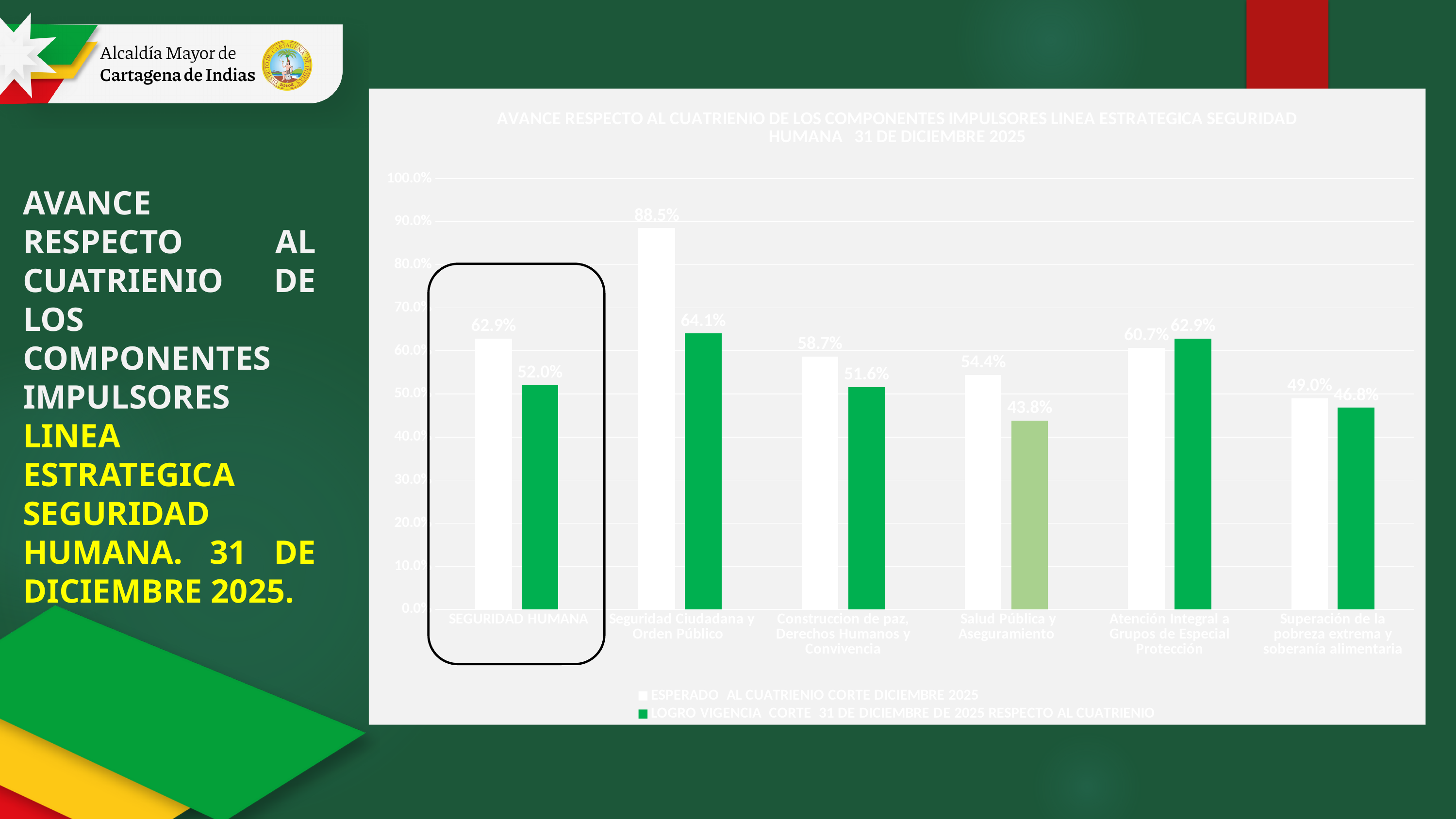
What is the difference between the ESPERADO and LOGRO values for Superación de la pobreza extrema y soberanía alimentaria? 2.2% How many series does the legend list? 2 What is the ESPERADO AL CUATRIENIO value for Seguridad Ciudadana y Orden Público? 88.5% Which category has the lowest LOGRO VIGENCIA value? Salud Pública y Aseguramiento What is the LOGRO VIGENCIA value for Salud Pública y Aseguramiento? 43.8% Which series is shown in white bars? ESPERADO AL CUATRIENIO CORTE DICIEMBRE 2025 For Atención Integral a Grupos de Especial Protección, which is larger: the ESPERADO value or the LOGRO value? LOGRO (62.9%) What is the difference between the ESPERADO and LOGRO values for Seguridad Ciudadana y Orden Público? 24.4% What type of chart is shown on the slide? bar chart What is the LOGRO VIGENCIA value for SEGURIDAD HUMANA? 52.0% How many categories are shown on the x axis? 6 Which category has the highest ESPERADO AL CUATRIENIO value? Seguridad Ciudadana y Orden Público